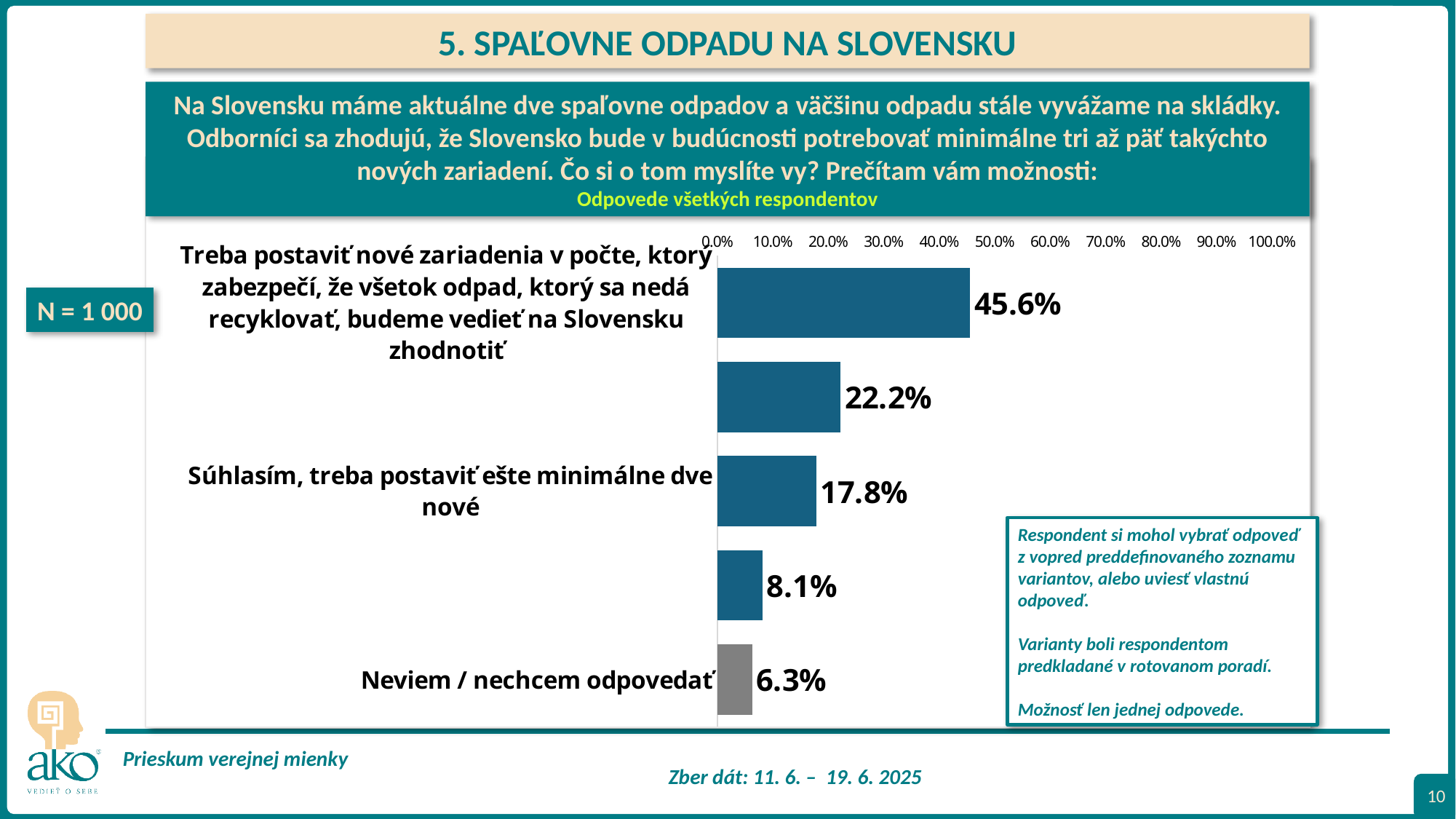
What is the difference in percentage points between "Treba postaviť nové zariadenia..." (45.6%) and "Súhlasím, treba postaviť ešte minimálne dve nové" (17.8%)? 27.8 percentage points What percentage of respondents chose "Neviem / nechcem odpovedať"? 6.3% What is the value shown for the option "Treba postaviť nové zariadenia v počte, ktorý zabezpečí, že všetok odpad, ktorý sa nedá recyklovať, budeme vedieť na Slovensku zhodnotiť"? 45.6% Which is larger: the share for "Súhlasím, treba postaviť ešte minimálne dve nové" or for "Neviem / nechcem odpovedať"? Súhlasím, treba postaviť ešte minimálne dve nové What is the sample size (N) stated on the slide? N = 1 000 How many bars are plotted in the chart? 5 Is the value for "Treba postaviť nové zariadenia..." greater or less than 40.0%? greater What is the value shown for "Súhlasím, treba postaviť ešte minimálne dve nové"? 17.8% How many percentage points higher is "Súhlasím, treba postaviť ešte minimálne dve nové" than "Neviem / nechcem odpovedať"? 11.5 percentage points Which response option has the lowest share of respondents? Neviem / nechcem odpovedať What type of chart is shown on the slide? Bar chart Which response option has the highest share of respondents? Treba postaviť nové zariadenia v počte, ktorý zabezpečí, že všetok odpad, ktorý sa nedá recyklovať, budeme vedieť na Slovensku zhodnotiť